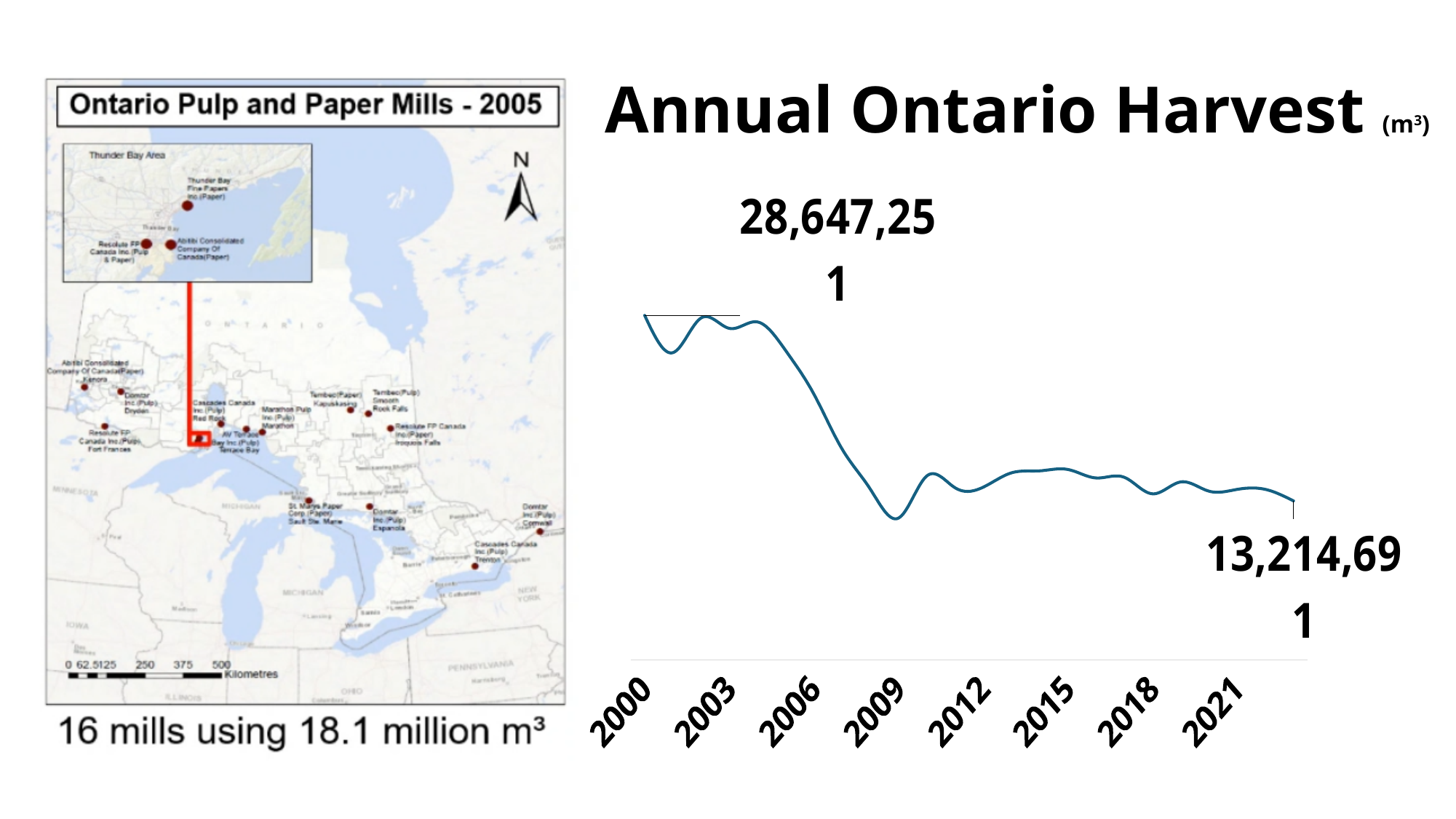
How many year labels are shown on the x axis of the Annual Ontario Harvest chart? 8 What kind of chart is the Annual Ontario Harvest chart? line chart What is the value of the last data point on the Annual Ontario Harvest chart? 13,214,691 What is the difference between the two labelled values on the Annual Ontario Harvest chart, 28,647,251 and 13,214,691? 15,432,560 On the Annual Ontario Harvest chart, is the harvest higher in 2000 or in 2021? 2000 What is the lowest value labelled on the Annual Ontario Harvest chart? 13,214,691 What is the highest value labelled on the Annual Ontario Harvest chart? 28,647,251 What is the last year labelled on the x axis of the Annual Ontario Harvest chart? 2021 On the Annual Ontario Harvest chart, does the harvest generally rise or fall from 2000 to the end of the series? fall What is the first year labelled on the x axis of the Annual Ontario Harvest chart? 2000 What is the title of the chart on the right of the slide? Annual Ontario Harvest In what unit is the Annual Ontario Harvest measured, according to the chart title? m³